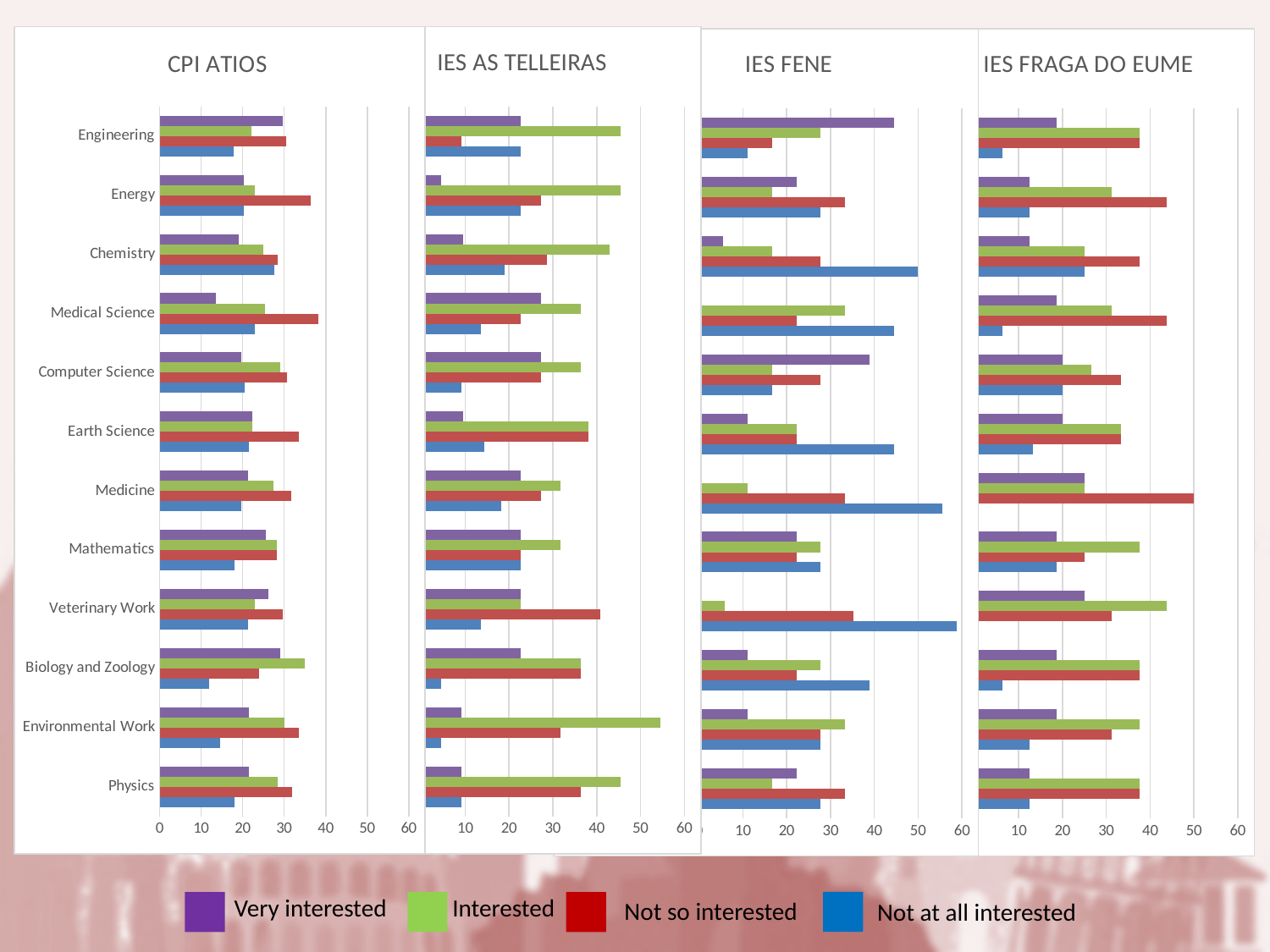
In the IES AS TELLEIRAS chart, is the Interested value for Environmental Work greater or less than 50? greater How many series does the legend at the bottom of the slide list? 4 In the IES FRAGA DO EUME chart, is the Not so interested value for Medicine greater or less than 40? greater In the IES FENE chart, for Engineering, which is larger: Very interested or Not at all interested? Very interested What are the four series named in the legend? Very interested, Interested, Not so interested, Not at all interested What kind of chart is used on this slide for CPI ATIOS? Bar chart In the IES FENE chart, is the Not at all interested value for Medicine greater or less than 50? greater How many categories (fields of study) are listed on the CPI ATIOS chart? 12 What are the titles of the four charts on the slide? CPI ATIOS, IES AS TELLEIRAS, IES FENE, IES FRAGA DO EUME In the IES AS TELLEIRAS chart, which category has the highest Interested value? Environmental Work